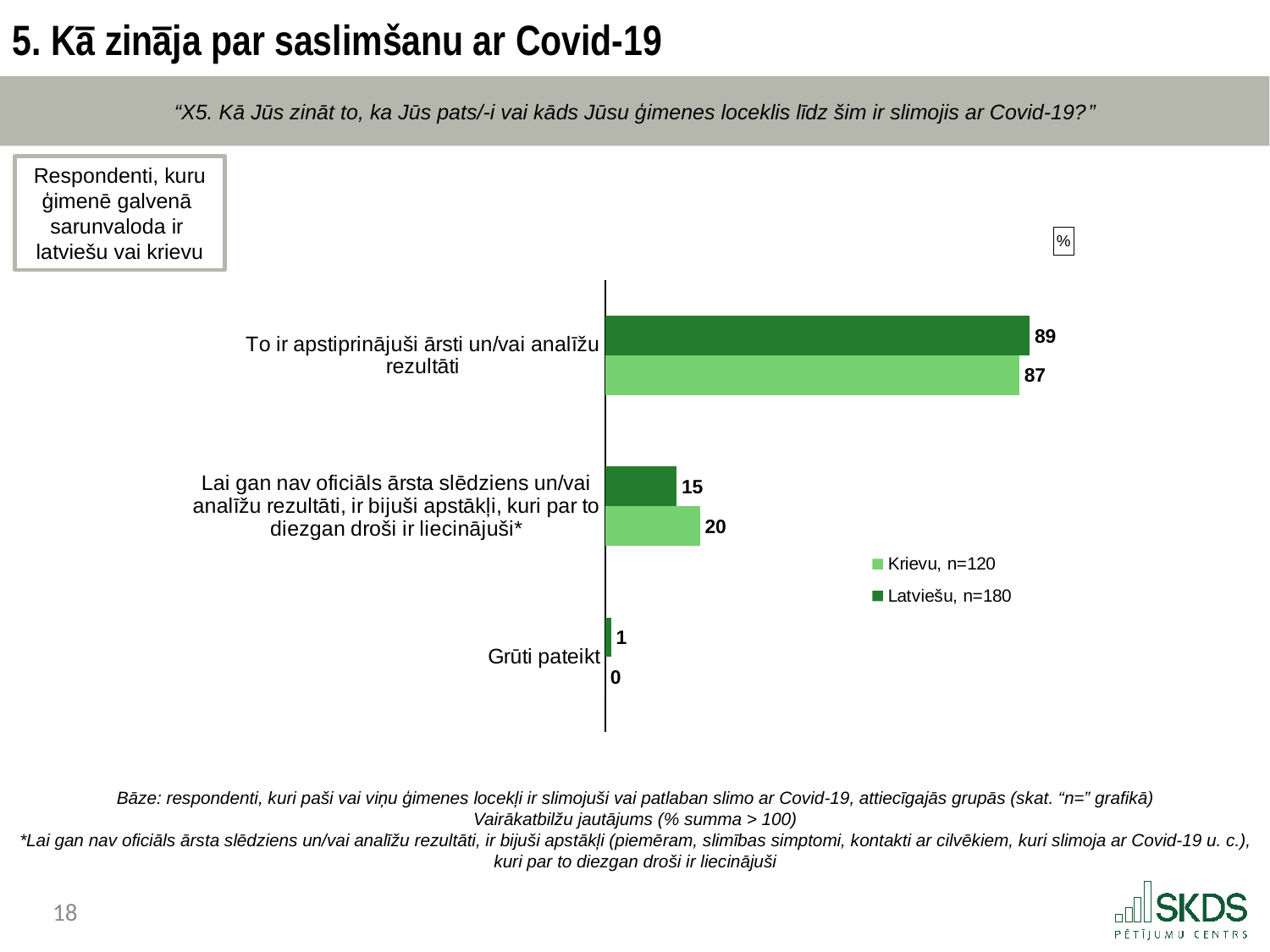
Which category has the lowest value for Latviešu, n=180? Grūti pateikt What is the value for Krievu, n=120 in the category "To ir apstiprinājuši ārsti un/vai analīžu rezultāti"? 87 Which colour represents the Krievu, n=120 series in the chart? light green How many categories are shown on the chart? 3 In the category "To ir apstiprinājuši ārsti un/vai analīžu rezultāti", which series has the larger value, Krievu, n=120 or Latviešu, n=180? Latviešu, n=180 What is the value for Latviešu, n=180 in the category "To ir apstiprinājuši ārsti un/vai analīžu rezultāti"? 89 What kind of chart is shown on the slide? bar chart What is the value for Krievu, n=120 in the category "Lai gan nav oficiāls ārsta slēdziens un/vai analīžu rezultāti, ir bijuši apstākļi, kuri par to diezgan droši ir liecinājuši*"? 20 What is the difference between the Krievu, n=120 and Latviešu, n=180 values in the category "Lai gan nav oficiāls ārsta slēdziens un/vai analīžu rezultāti, ir bijuši apstākļi, kuri par to diezgan droši ir liecinājuši*"? 5 How many series does the legend list? 2 What is the value for Latviešu, n=180 in the category "Grūti pateikt"? 1 Which category has the highest value for Krievu, n=120? To ir apstiprinājuši ārsti un/vai analīžu rezultāti